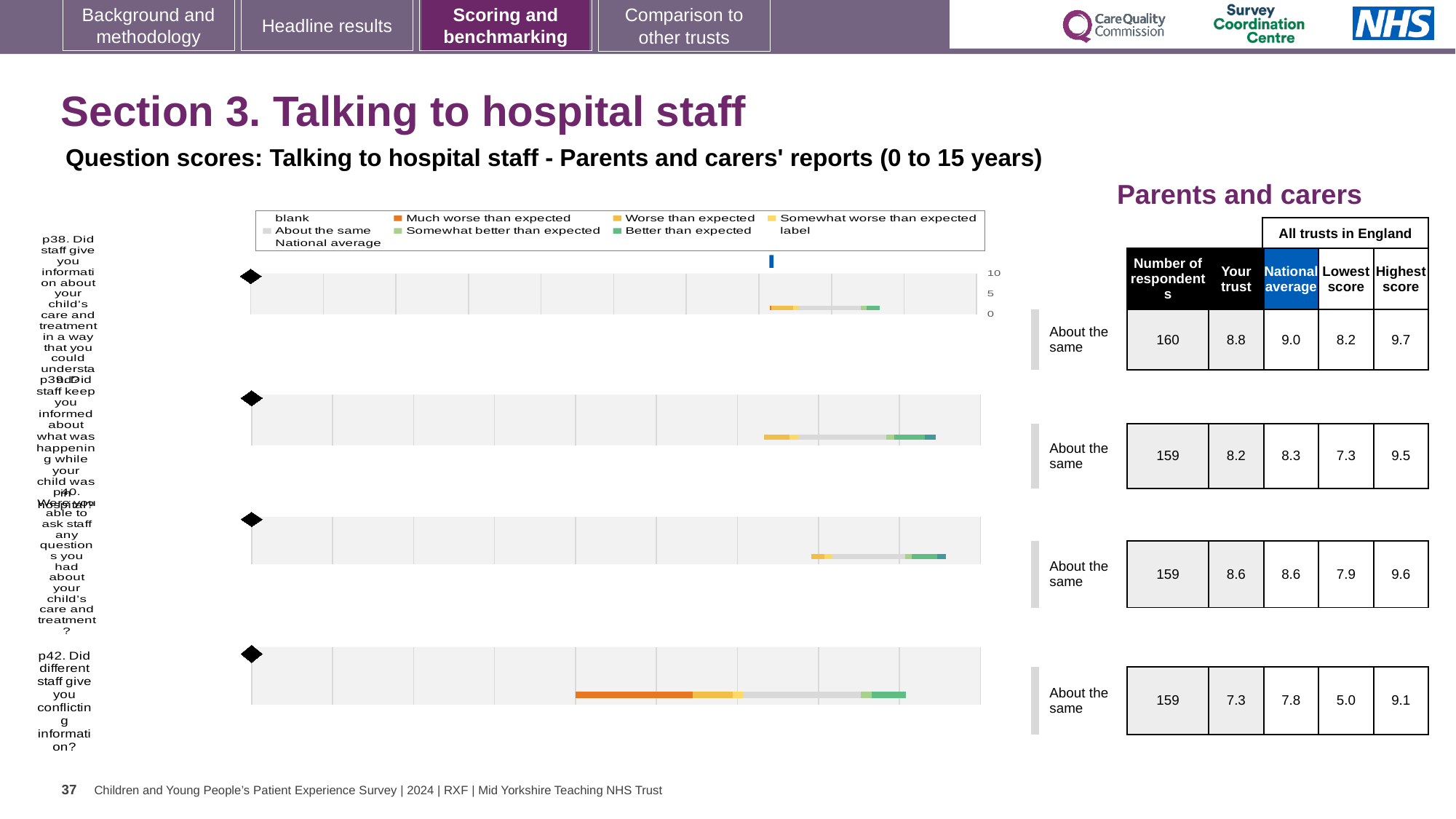
What is the 'Your trust' score for p38 (Did staff give you information about your child's care and treatment in a way that you could understand)? 8.8 For p38, which is higher: the 'Your trust' score or the national average? National average How many question charts (p38, p39, p40, p42) are shown on the slide? 4 Which question has the highest 'Your trust' score? p38 What is the national average score for p42 (Did different staff give you conflicting information)? 7.8 How many respondents answered p38? 160 Which question has the lowest 'Your trust' score? p42 For p42, what is the difference between the highest score (9.1) and the lowest score (5.0) across all trusts in England? 4.1 What kind of chart is used to show the benchmarking results for each question on this slide? bar chart Which question's chart has the widest orange 'Much worse than expected' segment? p42 In the chart legend, which colour represents 'Much worse than expected'? orange In the chart legend, which colour represents 'Better than expected'? green